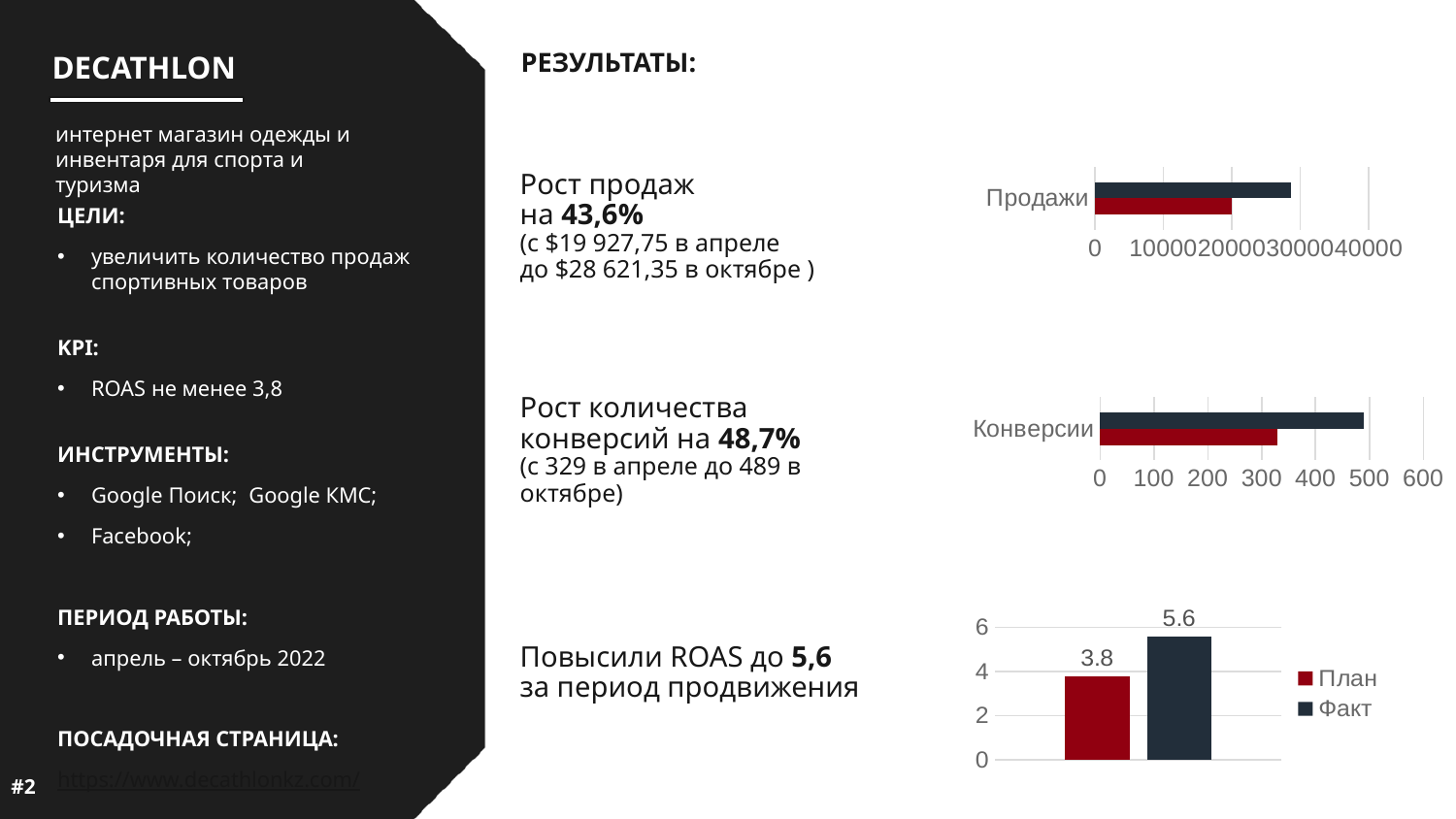
In the bottom chart with the legend План and Факт, what colour is the План bar? Dark red In the bottom chart with the legend План and Факт, what is the value of the План bar? 3.8 In the bottom chart with the legend План and Факт, is the Факт value greater or less than 4? greater In the Конверсии chart, is the value of the longer (dark) bar greater or less than 400? greater In the bottom chart with the legend План and Факт, what is the value of the Факт bar? 5.6 In the bottom chart with the legend План and Факт, how many series does the legend list? 2 In the bottom chart with the legend План and Факт, which series has the higher value? Факт In the Продажи chart, is the value of the longer (dark) bar greater or less than 20000? greater What type of chart is the Продажи chart? Bar chart What type of chart is the bottom chart with the legend План and Факт? Bar chart In the bottom chart with the legend План and Факт, what is the difference between the Факт and План values? 1.8